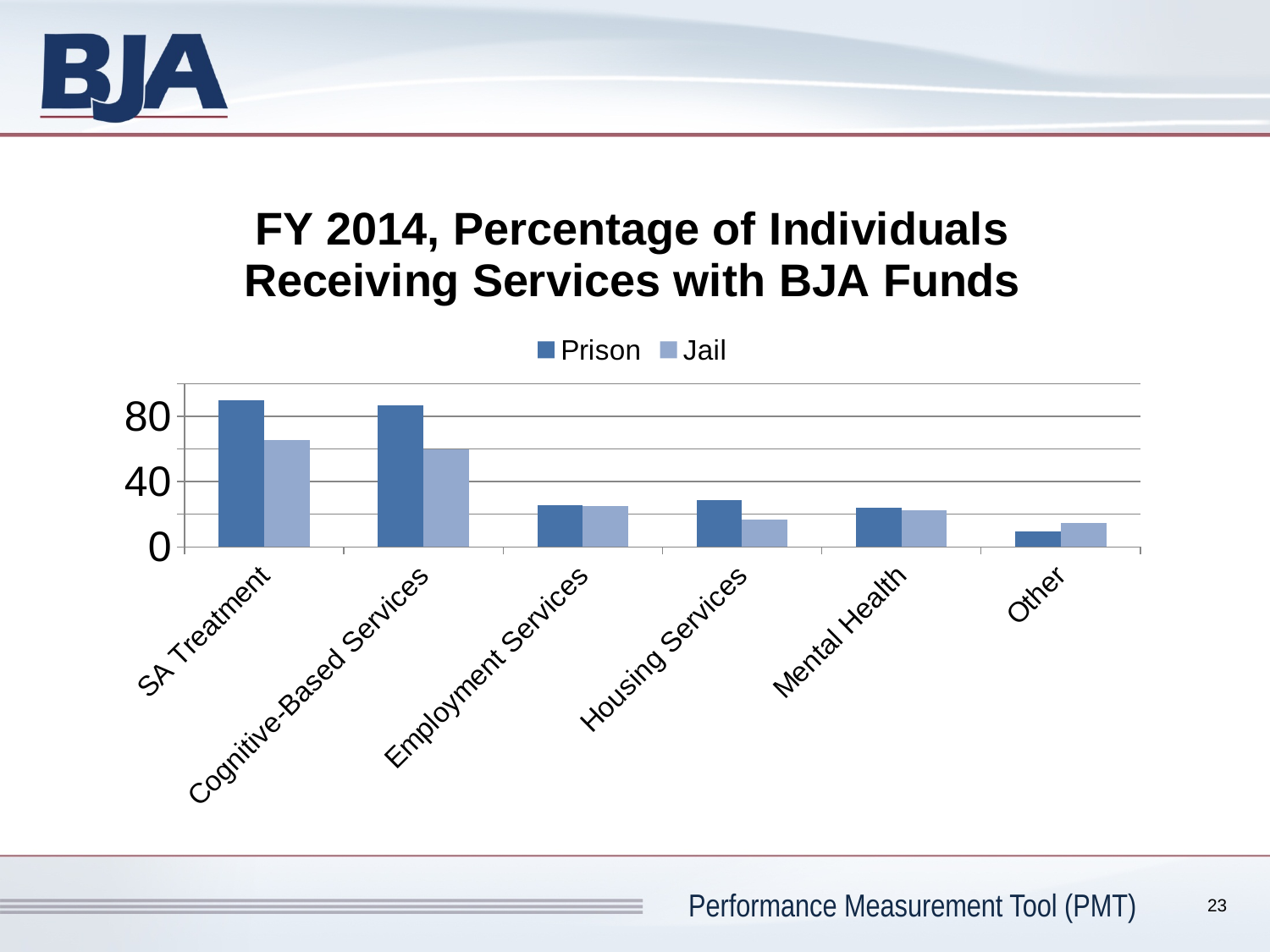
Is the Prison value for Cognitive-Based Services greater or less than 80? greater For SA Treatment, which is larger, the Prison value or the Jail value? Prison Is the Prison value for Employment Services greater or less than 40? less How many series does the legend list? 2 How many service categories are shown on the x axis? 6 What kind of chart is shown on the slide? Bar chart Is the Jail value for Other greater or less than 40? less What are the two series named in the legend? Prison and Jail For Other, which is larger, the Prison value or the Jail value? Jail Which category has the lowest Prison value? Other